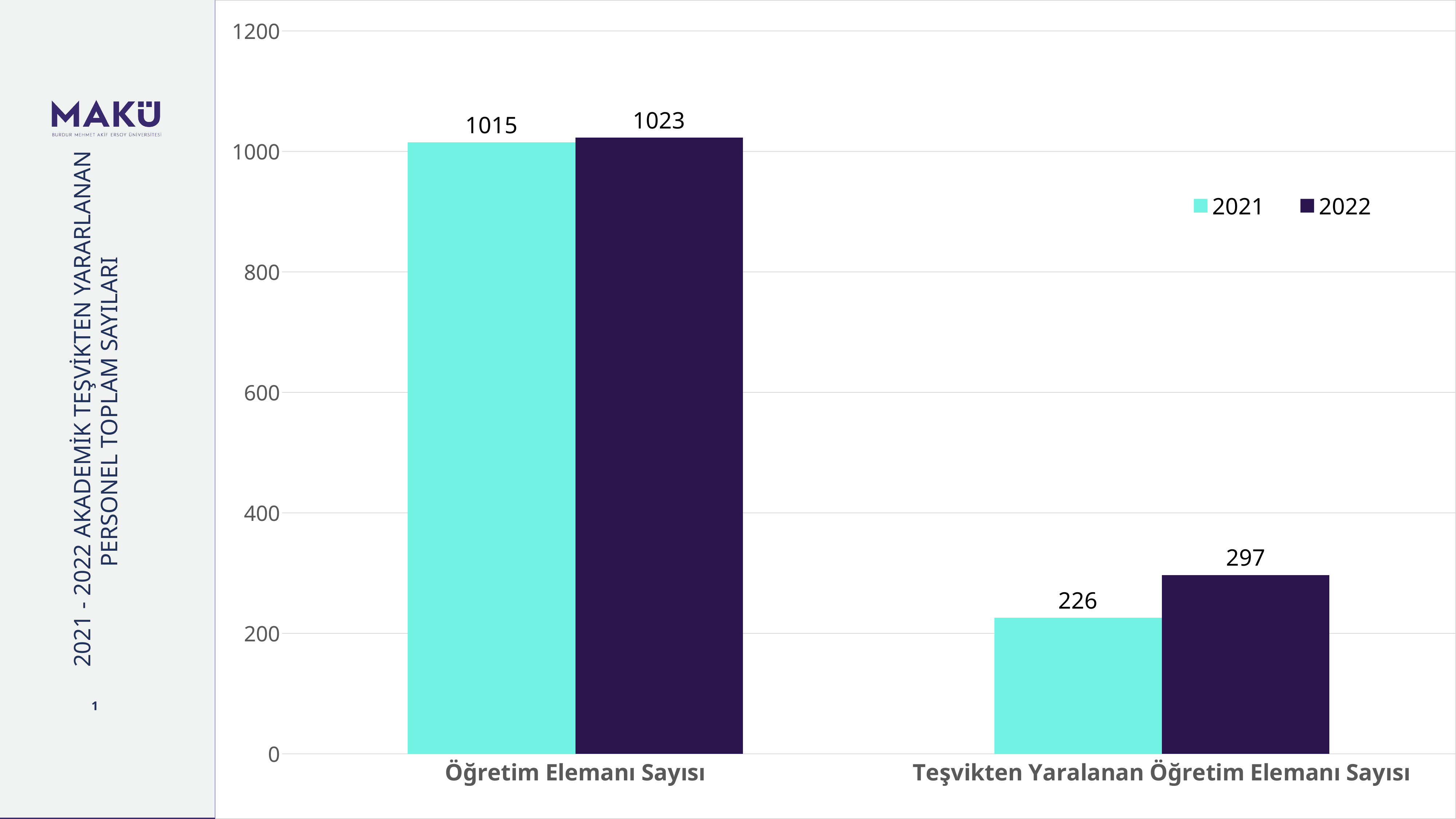
What kind of chart is shown on the slide? bar chart What is the value for Öğretim Elemanı Sayısı in 2021? 1015 What is the difference between the 2022 and 2021 values for Teşvikten Yaralanan Öğretim Elemanı Sayısı? 71 What is the difference between the 2022 and 2021 values for Öğretim Elemanı Sayısı? 8 Which is larger for Teşvikten Yaralanan Öğretim Elemanı Sayısı, the 2021 value or the 2022 value? 2022 What is the value for Teşvikten Yaralanan Öğretim Elemanı Sayısı in 2022? 297 Is the 2022 value for Teşvikten Yaralanan Öğretim Elemanı Sayısı greater or less than 400? less How many series does the legend list? 2 What is the value for Öğretim Elemanı Sayısı in 2022? 1023 Which category has the lowest value in the 2021 series? Teşvikten Yaralanan Öğretim Elemanı Sayısı What is the value for Teşvikten Yaralanan Öğretim Elemanı Sayısı in 2021? 226 How many categories are shown on the x axis? 2